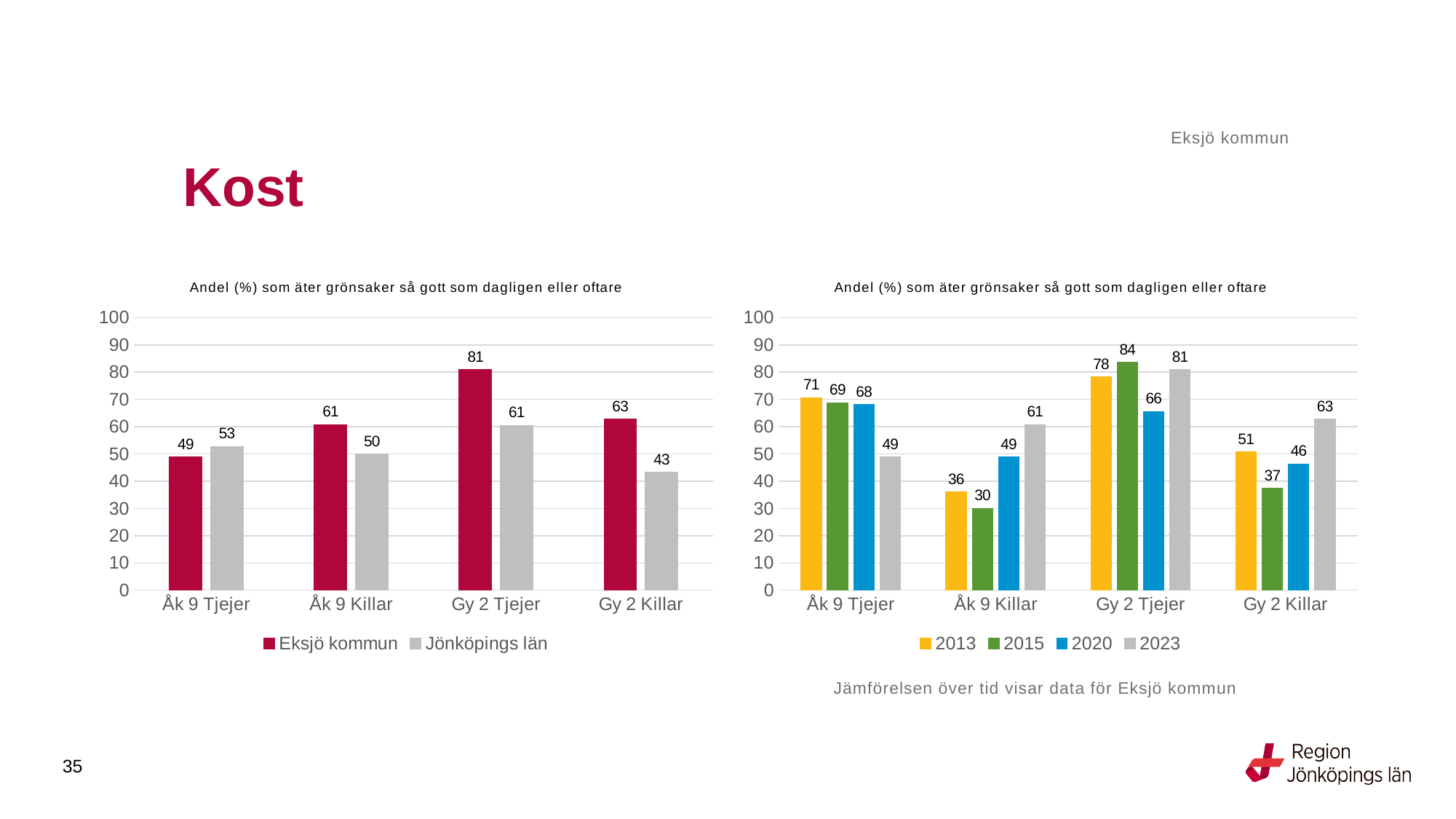
In the right chart, what is the value for 2013 for Åk 9 Killar? 36 In the right chart, what is the difference between the 2023 and 2020 values for Gy 2 Killar? 17 In the left chart, which is larger for Åk 9 Tjejer: Eksjö kommun or Jönköpings län? Jönköpings län In the right chart, what is the value for 2015 for Gy 2 Tjejer? 84 In the left chart, what is the difference between Eksjö kommun and Jönköpings län for Gy 2 Killar? 20 In the left chart, what is the value for Eksjö kommun for Gy 2 Tjejer? 81 In the left chart, what is the value for Jönköpings län for Gy 2 Killar? 43 In the left chart, how many series does the legend list? 2 What kind of chart is the right chart? Bar chart In the right chart, which category has the lowest value for 2015? Åk 9 Killar In the right chart, how many series does the legend list? 4 In the left chart, which category has the highest value for Eksjö kommun? Gy 2 Tjejer